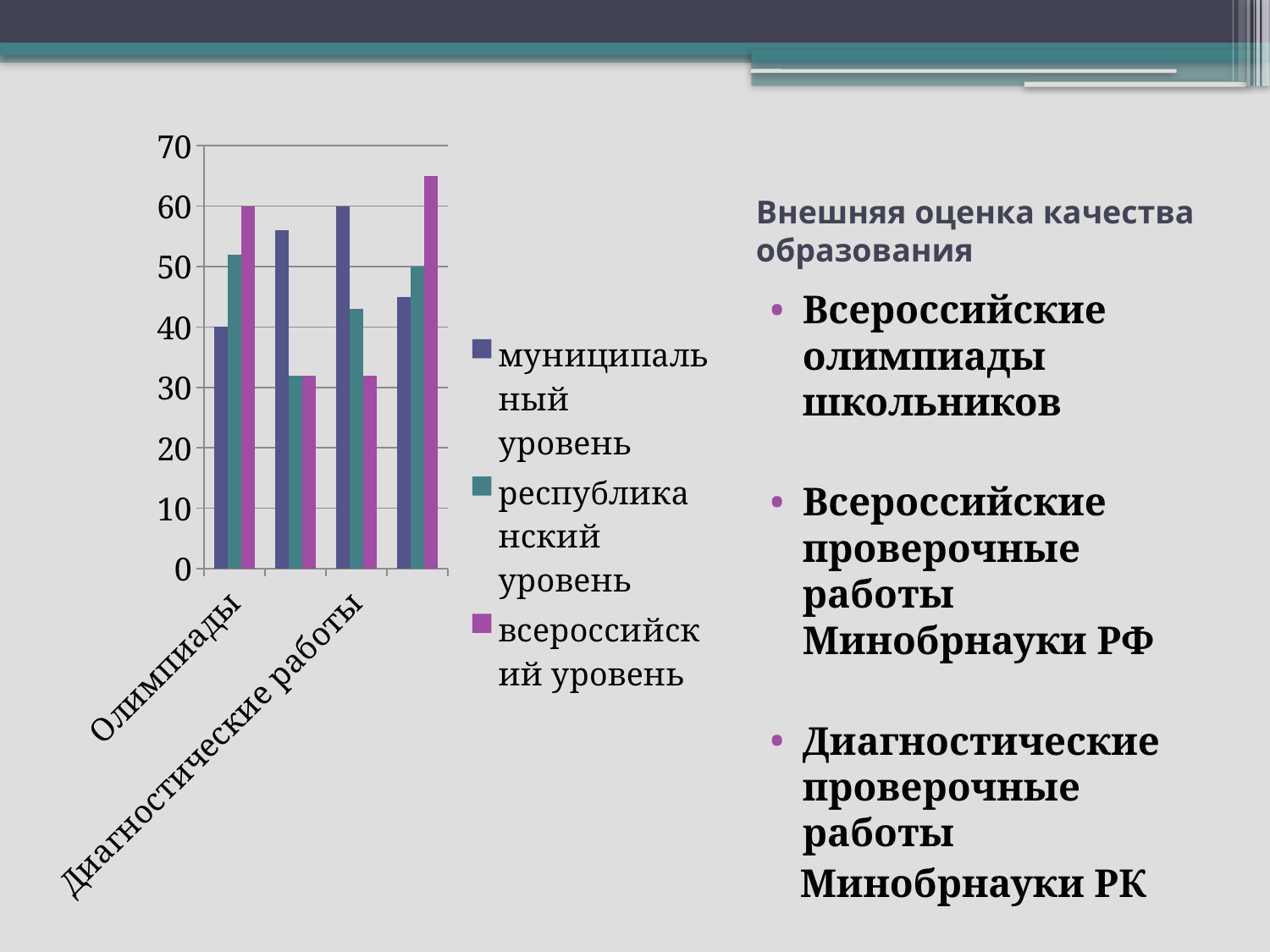
Which series has the lowest bar in the Олимпиады group? муниципальный уровень What is the value of the всероссийский уровень bar for Олимпиады? 60 What colour represents всероссийский уровень in the chart legend? purple In the second group of bars from the left, is the муниципальный уровень value greater or less than 50? greater What kind of chart is shown on the slide? bar chart What is the value of the муниципальный уровень bar for Олимпиады? 40 How many series does the chart legend list? 3 Which series has the highest bar in the Олимпиады group? всероссийский уровень How many groups of bars are plotted in the chart? 4 Is the value of the республиканский уровень bar for Олимпиады greater or less than 60? less In the rightmost group of bars, which is larger: the всероссийский уровень bar or the муниципальный уровень bar? всероссийский уровень What is the highest value shown on the chart's vertical axis? 70